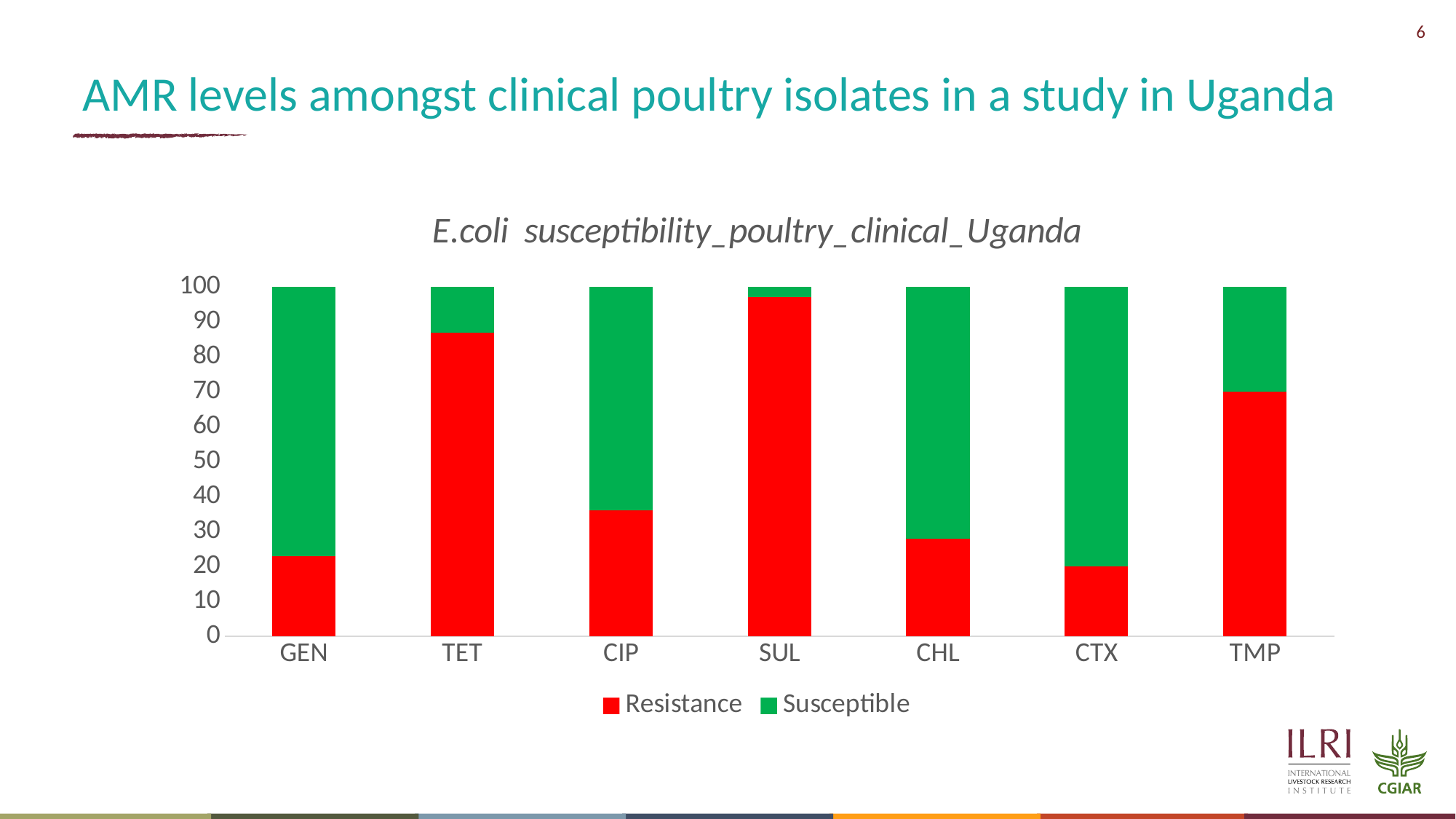
Is the Resistance value for TMP greater or less than 60? greater What kind of chart is shown on the slide? Stacked bar chart Which has a larger Resistance value, TET or TMP? TET Is the Susceptible value for CTX greater or less than 70? greater Is the Resistance value for TET greater or less than 80? greater Which antibiotic has the highest Resistance value? SUL Which antibiotic has the lowest Susceptible value? SUL How many antibiotic categories are shown on the x axis? 7 What colour represents the Resistance series in the chart? Red Which has a larger Resistance value, CIP or CHL? CIP How many series does the legend list? 2